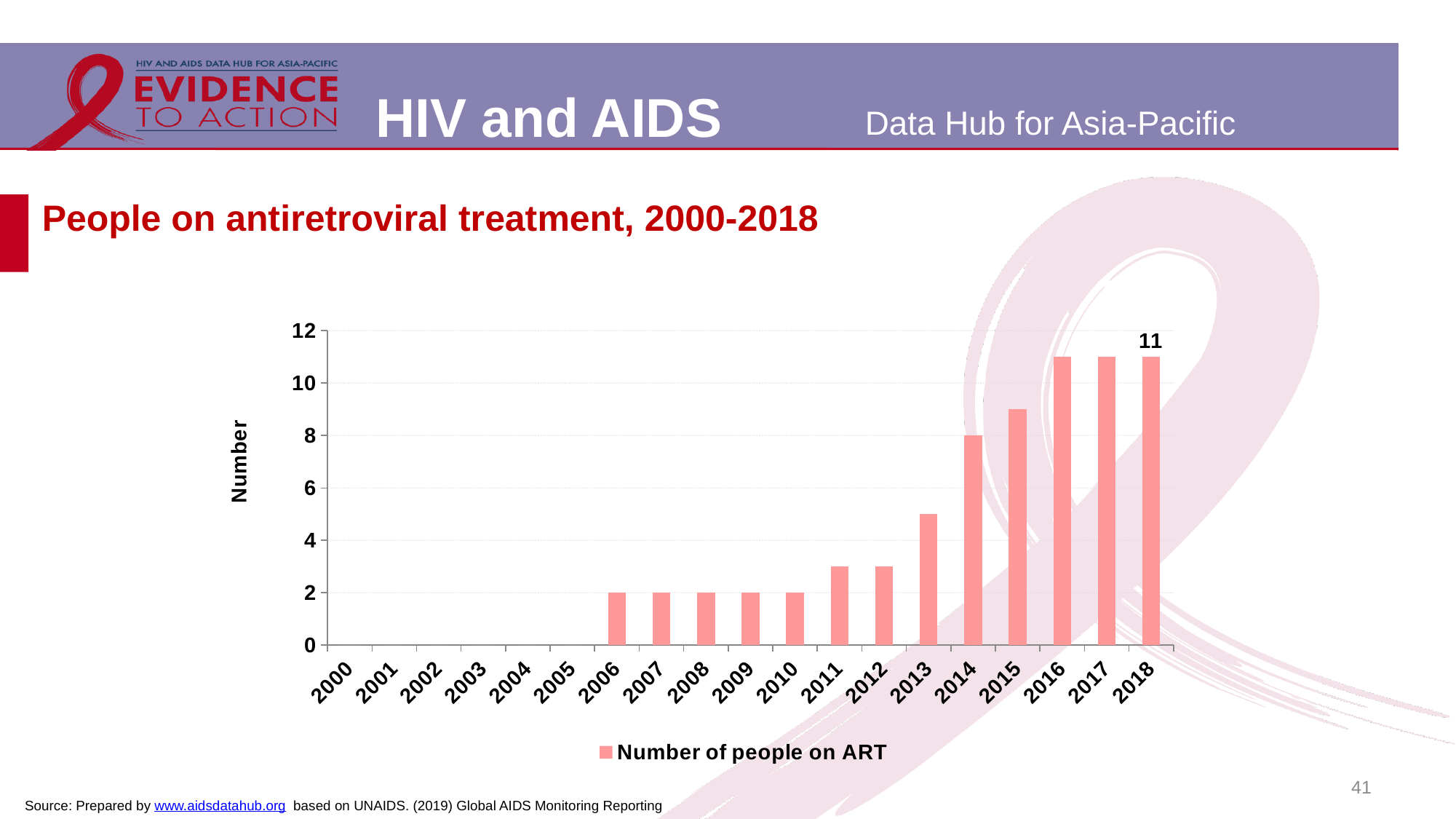
What is the difference between the values for 2014 and 2006? 6 What kind of chart is shown on the slide? bar chart How many series does the legend list? 1 What is the number of people on ART in 2006? 2 Is the value for 2011 greater or less than 4? less What is the number of people on ART in 2014? 8 Is the value for 2013 greater or less than 4? greater Which year has the larger value, 2010 or 2014? 2014 Is the value for 2015 greater or less than 10? less How many years are shown on the x axis of the chart? 19 Do the values generally rise or fall from 2006 to 2018? rise What is the number of people on ART in 2018? 11